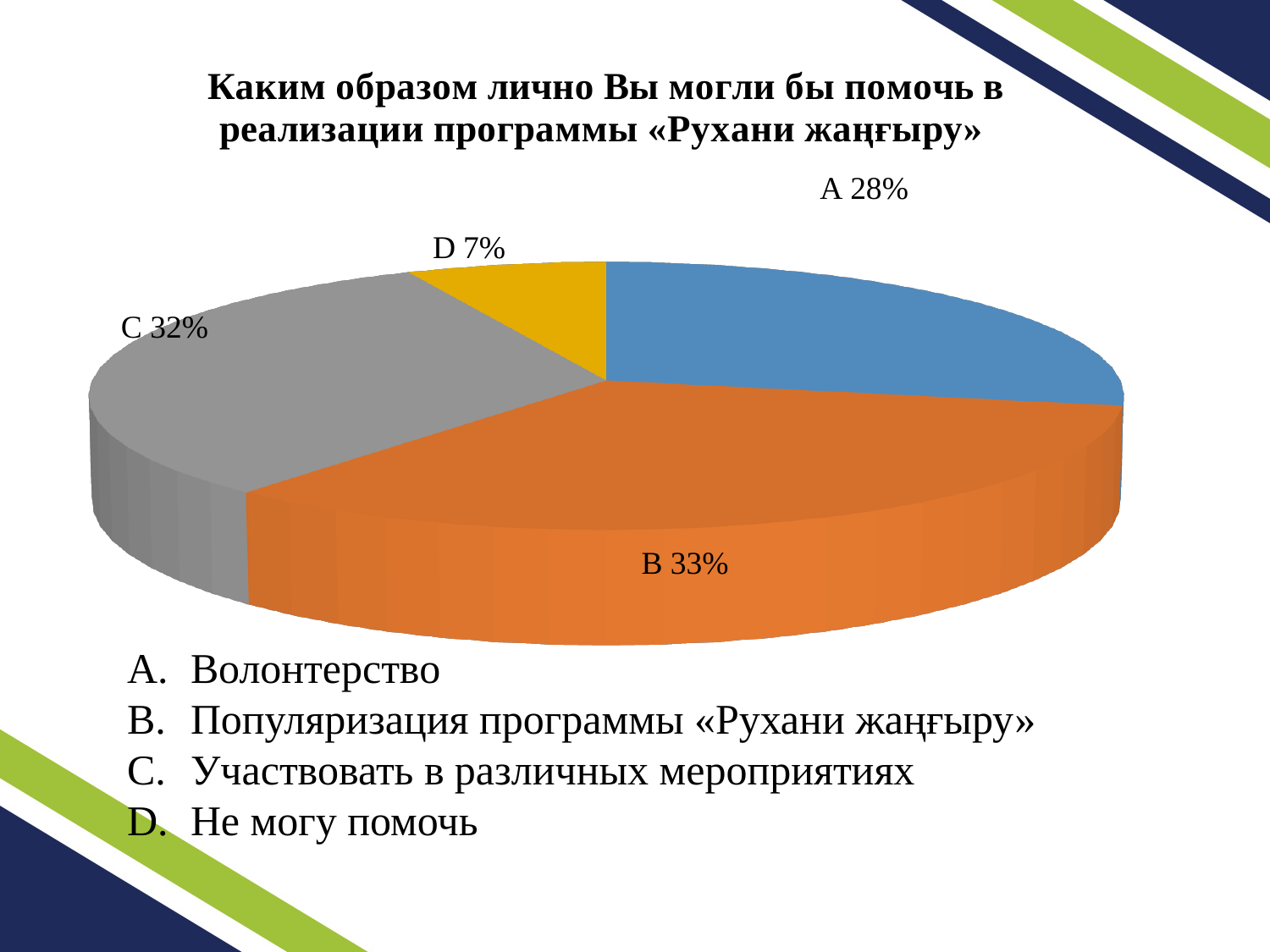
Which slice has the smallest share of the pie? D What is the difference in percentage points between slice B and slice D? 26 What percentage is shown for slice A? 28% What kind of chart is shown on the slide? Pie chart Which is larger, slice A or slice C? C What percentage is shown for slice D? 7% What answer option does slice D represent according to the list below the chart? Не могу помочь What percentage is shown for slice B? 33% What colour is slice B in the pie chart? Orange What percentage is shown for slice C? 32% How many slices does the pie chart have? 4 Which slice has the largest share of the pie? B